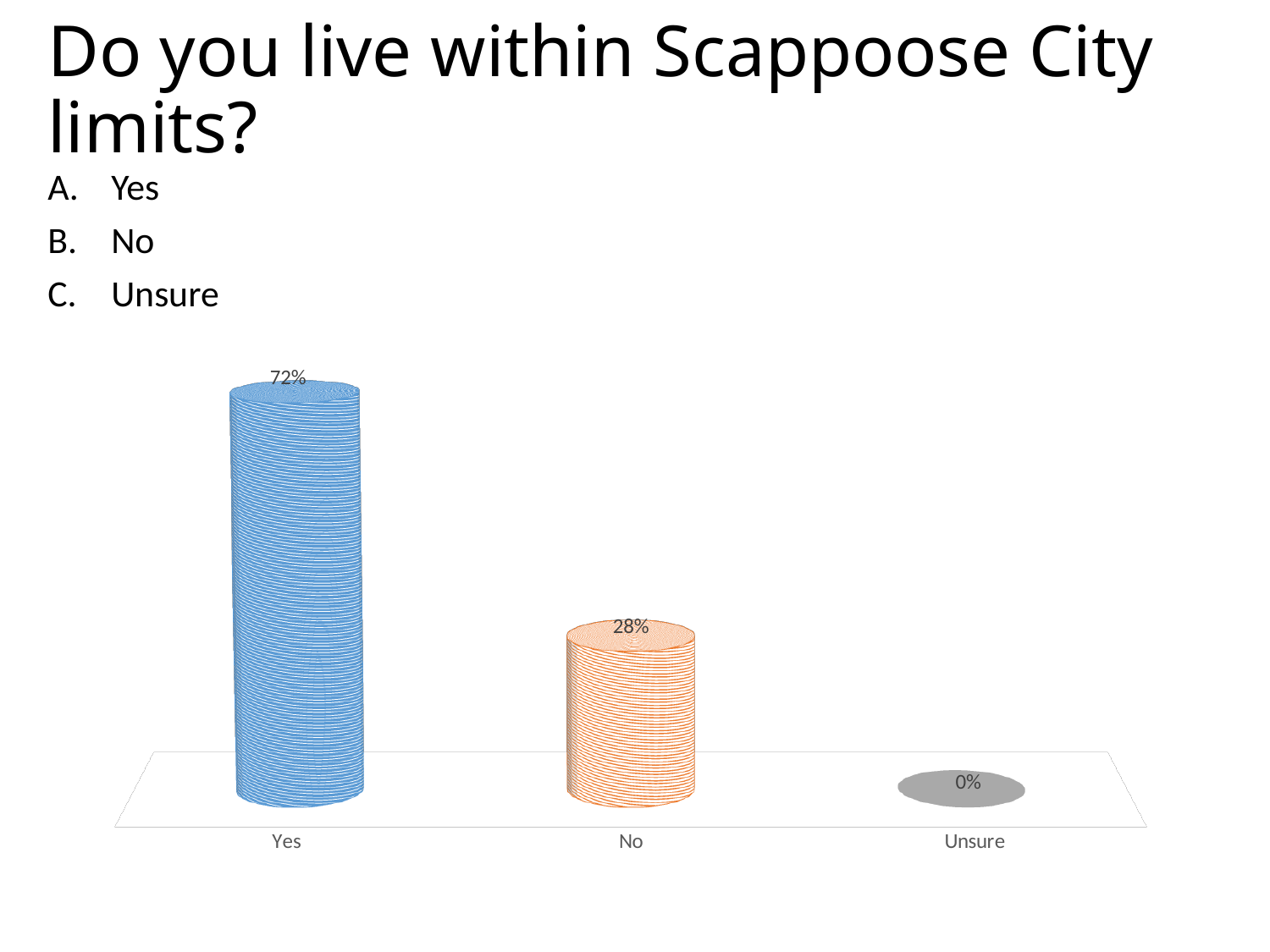
What kind of chart is shown on the slide? Bar chart Do the values rise or fall moving from Yes to Unsure along the x axis? Fall What percentage of respondents answered Yes? 72% Which is larger, the value for Yes or the value for No? Yes Which response category has the highest value? Yes How many response categories are shown on the chart? 3 What percentage of respondents answered No? 28% What percentage of respondents answered Unsure? 0% Which response category has the lowest value? Unsure What colour is the bar for the No category? Orange What is the difference between the Yes and No percentages? 44% What is the total of the Yes and No percentages? 100%